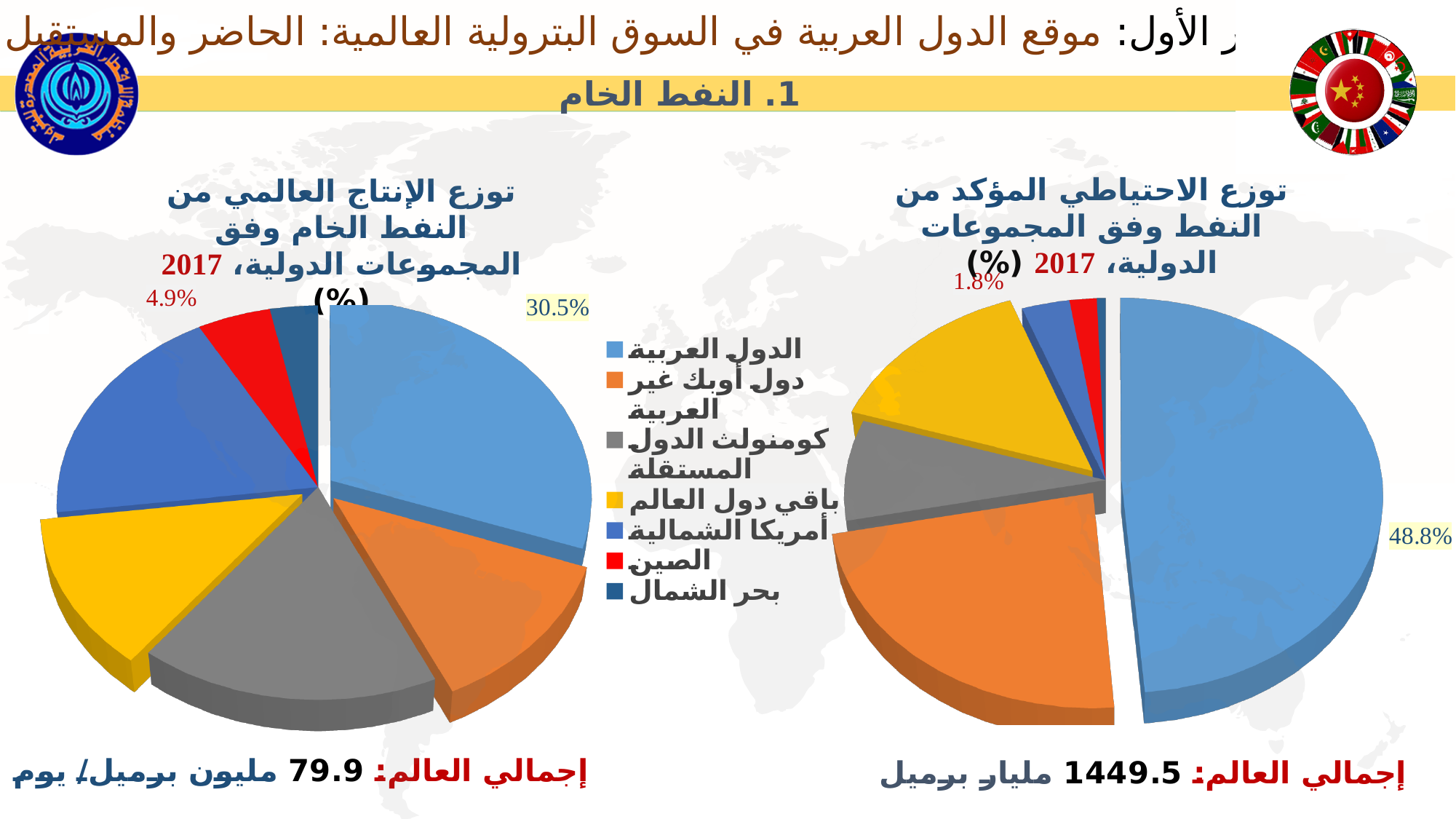
According to the text under the left chart, what is the world total crude oil production? 79.9 مليون برميل/يوم What type of chart is used on this slide? Pie chart In the right pie chart (توزع الاحتياطي المؤكد من النفط), what share is shown for الدول العربية? 48.8% In the left pie chart (توزع الإنتاج العالمي من النفط الخام), what share is shown for الدول العربية? 30.5% Is the share of الدول العربية larger in the left chart (production) or in the right chart (proven reserves)? Right chart (proven reserves) In the left pie chart (توزع الإنتاج العالمي من النفط الخام), which group has the largest slice? الدول العربية In the left pie chart (توزع الإنتاج العالمي من النفط الخام), what share is shown for الصين? 4.9% In the right pie chart (توزع الاحتياطي المؤكد من النفط), which slice is larger: دول أوبك غير العربية or كومنولث الدول المستقلة? دول أوبك غير العربية In the right pie chart (توزع الاحتياطي المؤكد من النفط), which group has the largest slice? الدول العربية In the right pie chart (توزع الاحتياطي المؤكد من النفط), which group has the smallest slice? بحر الشمال What is the difference between the share of الدول العربية in the right chart (48.8%) and in the left chart (30.5%)? 18.3 percentage points How many groups does the legend list for the pie charts? 7